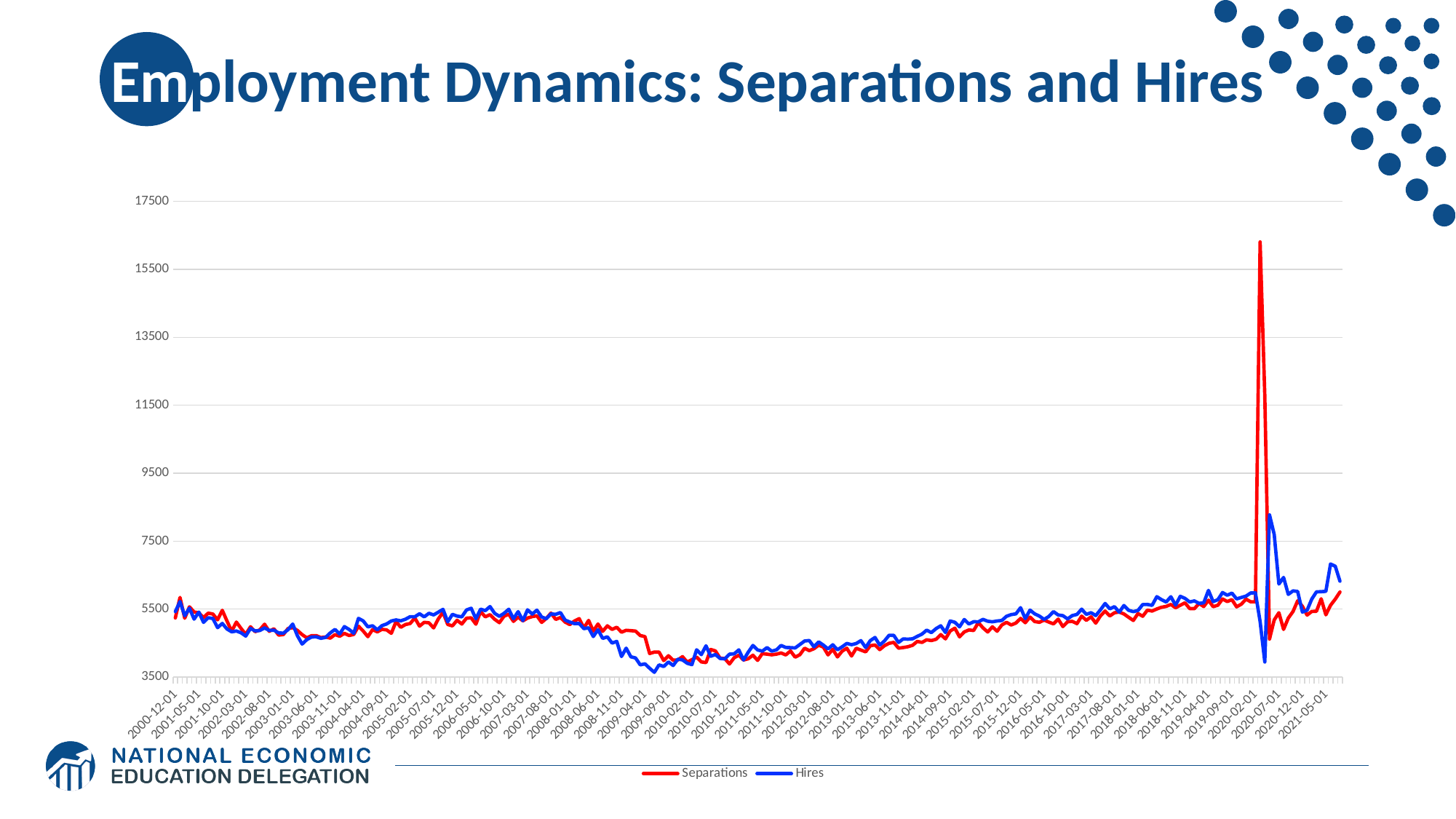
What is the title of the slide's chart? Employment Dynamics: Separations and Hires Which colour is used for the Hires series? blue Around 2009-04-01, which series has the higher value, Separations or Hires? Separations What kind of chart is shown on the slide? line chart Does the Separations series generally rise or fall between 2007-08-01 and 2009-09-01? fall How many series does the legend list? 2 Which series reaches the higher peak in 2020, Separations or Hires? Separations Is the value of Separations around 2012-03-01 greater or less than 5500? less Does the Hires series generally rise or fall between 2009-09-01 and 2019-09-01? rise Is the peak value of the Hires series in 2020 greater or less than 9500? less Is the peak value of the Separations series in 2020 greater or less than 15500? greater